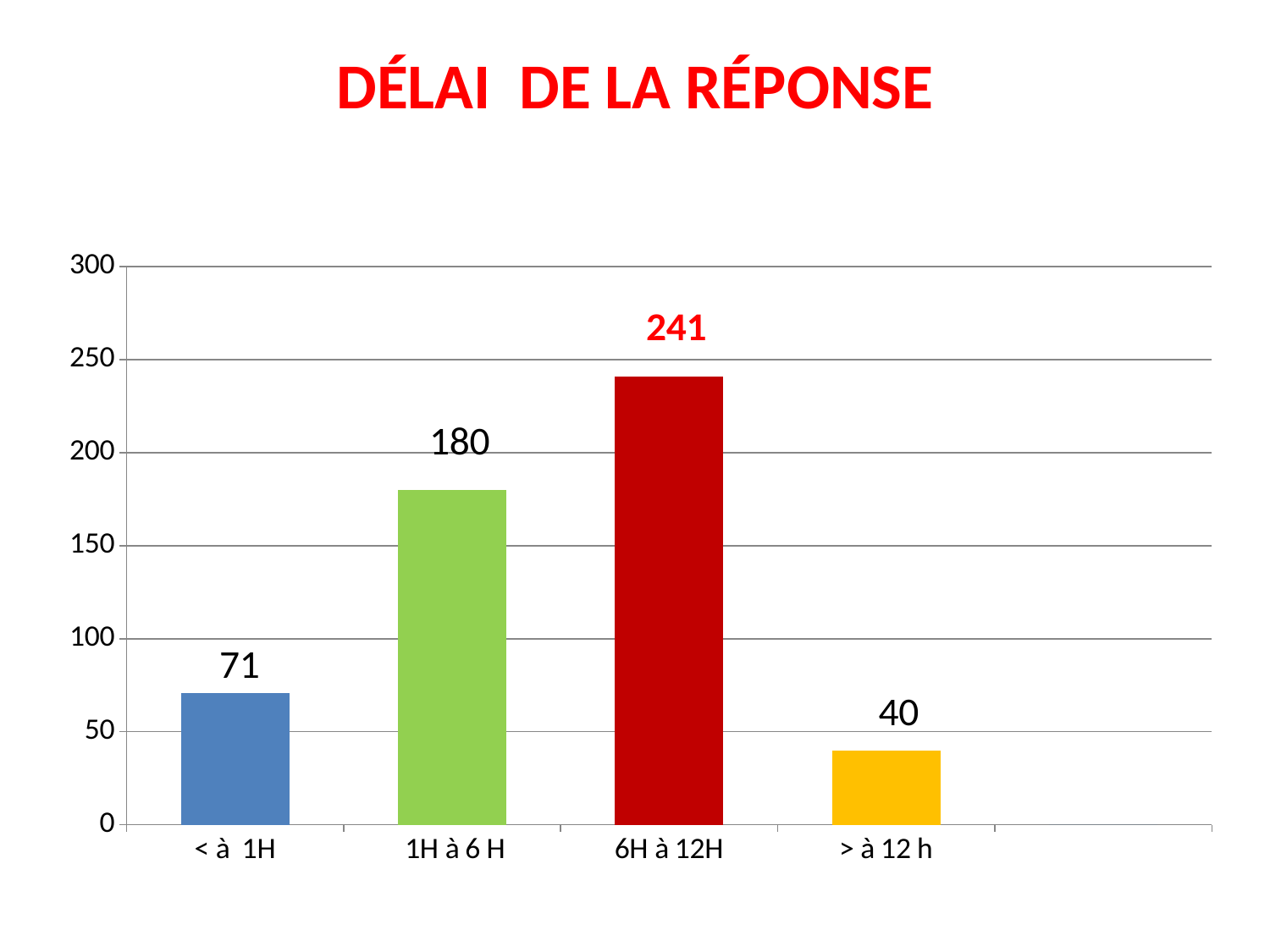
Is the value for "1H à 6 H" greater or less than 150? greater How many categories are shown on the x axis? 4 What is the title of the slide? DÉLAI DE LA RÉPONSE Which category has the lowest value? > à 12 h What is the value for the "< à 1H" category? 71 What is the difference between the values for "< à 1H" and "> à 12 h"? 31 What kind of chart is shown on the slide? Bar chart What is the value for the "6H à 12H" category? 241 Which is larger, the value for "1H à 6 H" or the value for "< à 1H"? 1H à 6 H Which category has the highest value? 6H à 12H What is the value for the "> à 12 h" category? 40 What is the difference between the values for "6H à 12H" and "1H à 6 H"? 61